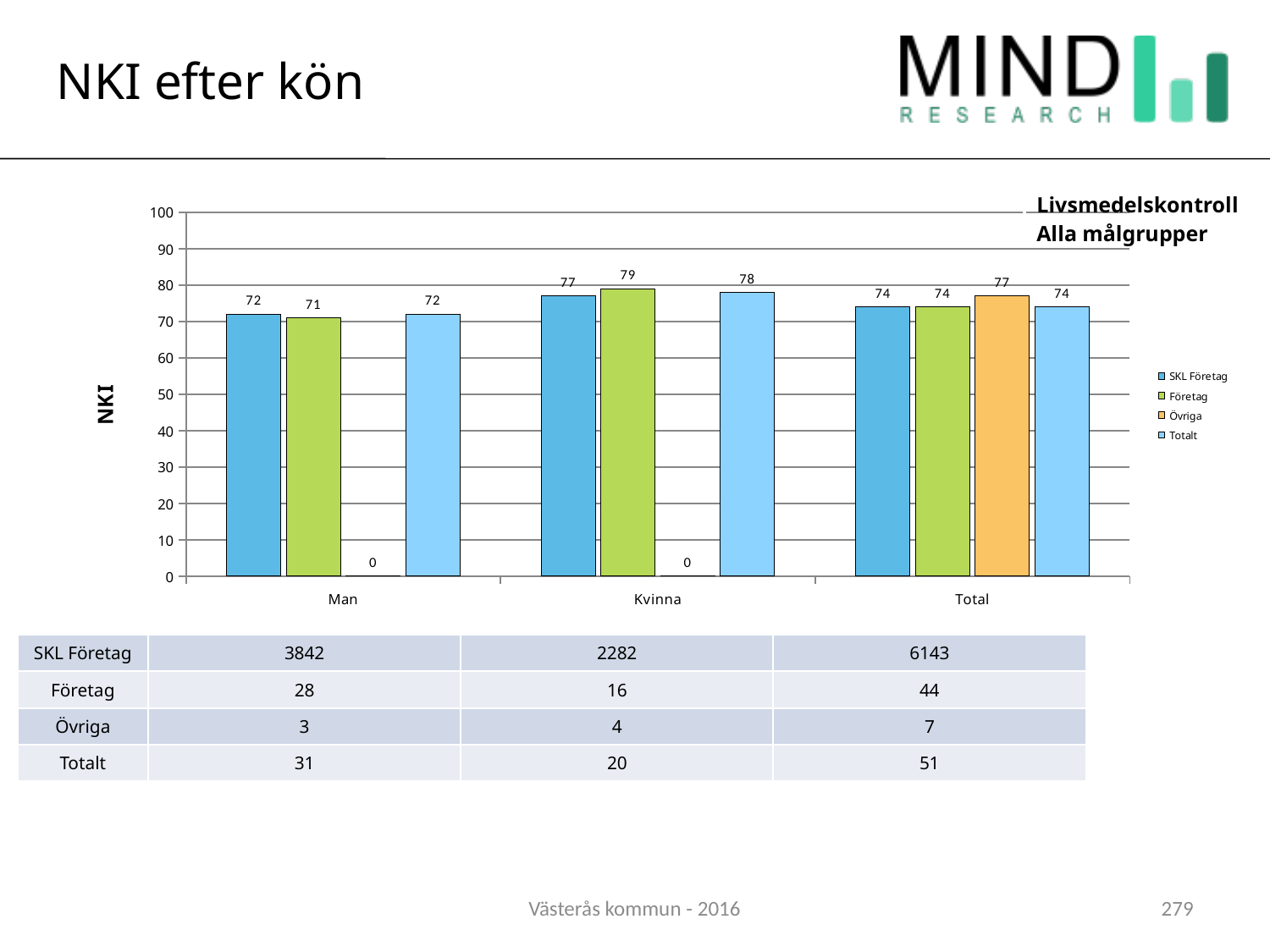
How many categories are shown on the x axis? 3 Which category has the lowest Totalt value? Man Which category has the highest Företag value? Kvinna What type of chart is shown on the slide? bar chart What is the NKI value for Företag in the Kvinna category? 79 What is the difference between the Totalt values for Kvinna and Man? 6 What is the label of the y axis? NKI What is the NKI value for Övriga in the Total category? 77 How many series does the legend list? 4 What is the NKI value for SKL Företag in the Man category? 72 What is the NKI value for Totalt in the Kvinna category? 78 Which is larger: the SKL Företag value for Kvinna or for Total? Kvinna